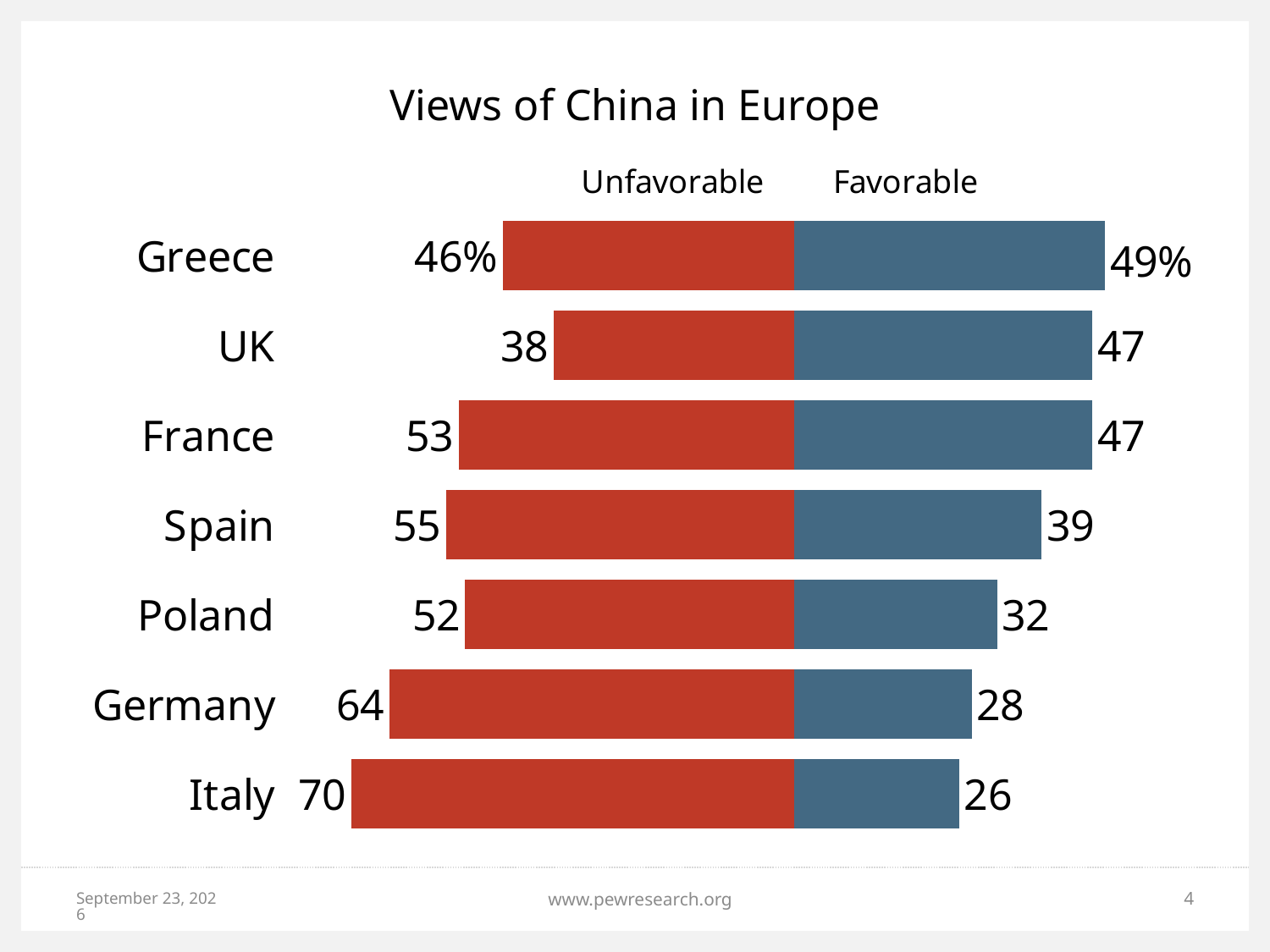
What is the Favorable value for Greece? 49% Which country has the highest Unfavorable value? Italy What is the Unfavorable value for Germany? 64 Which country has the lowest Favorable value? Italy Which country has the lowest Unfavorable value? UK What is the title of the chart? Views of China in Europe What is the difference between the Unfavorable and Favorable values for Italy? 44 What is the Favorable value for Poland? 32 What kind of chart is this? Bar chart How many series does the chart show? 2 Which is larger for Spain, the Unfavorable value or the Favorable value? Unfavorable How many countries are shown in the chart? 7